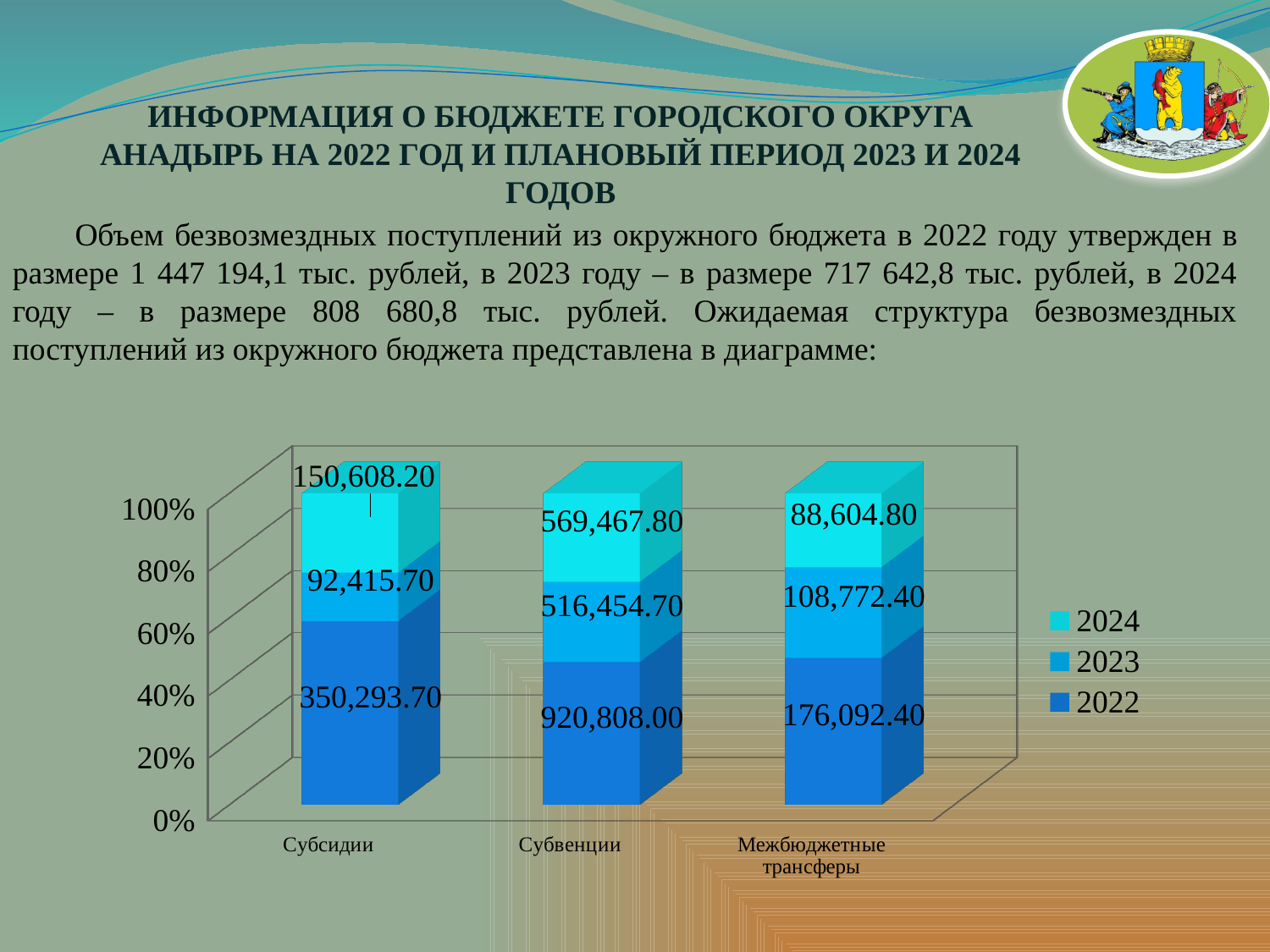
How many series does the legend list? 3 What is the total of the three values in the Межбюджетные трансферы bar? 373,469.60 Which category has the lowest value for the 2024 series? Межбюджетные трансферы What is the value for 2023 in the Субвенции bar? 516,454.70 What is the difference between the 2022 values for Субвенции and Субсидии? 570,514.30 What is the value for 2024 in the Межбюджетные трансферы bar? 88,604.80 Which series is shown in the darkest blue colour? 2022 Which is larger for Субсидии: the 2023 value or the 2024 value? 2024 What kind of chart is shown on the slide? Stacked bar chart Which category has the highest value for the 2022 series? Субвенции What is the value for 2022 in the Субсидии bar? 350,293.70 How many categories are shown on the x axis? 3